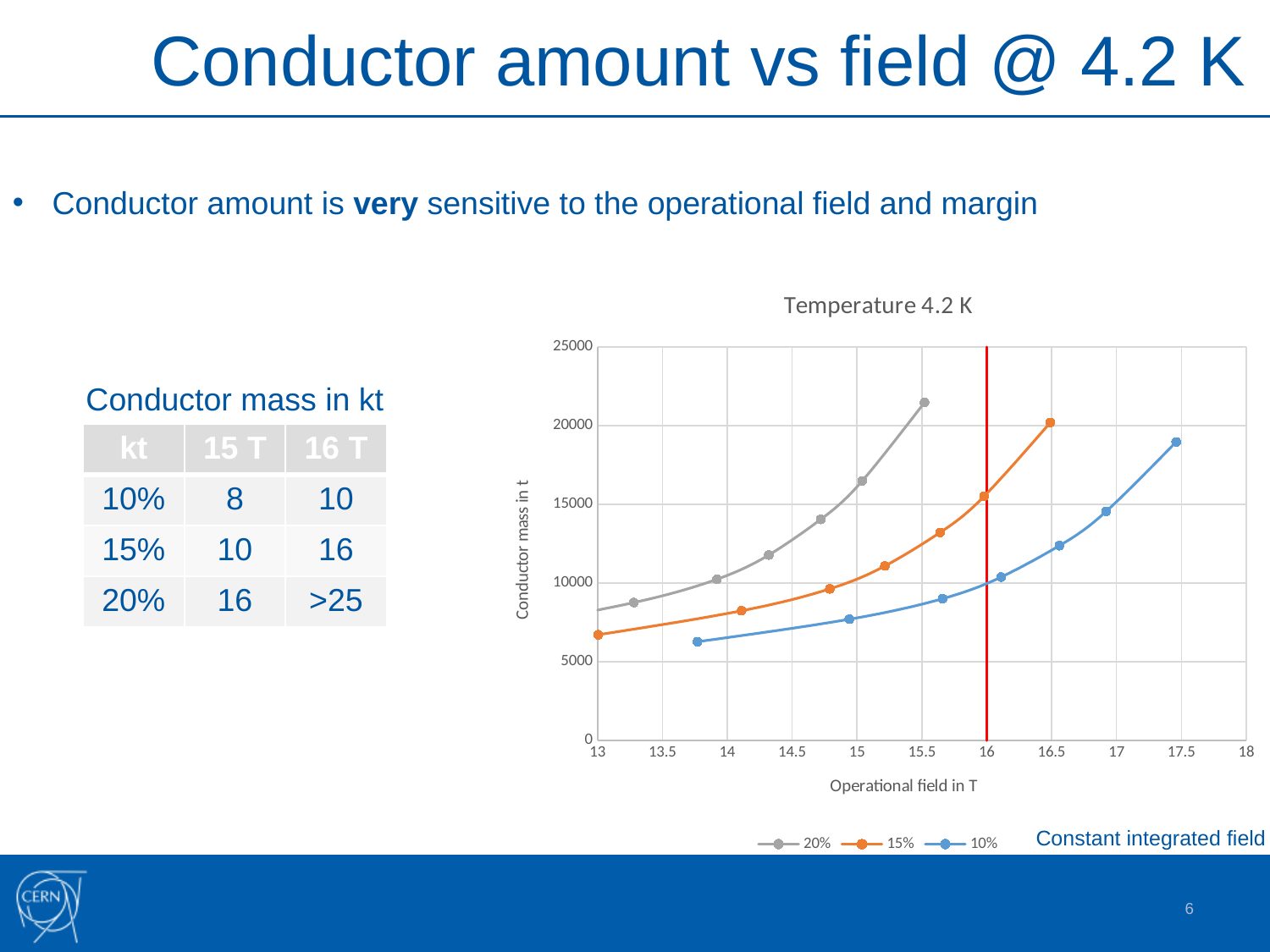
What kind of chart is shown under the title "Temperature 4.2 K"? line chart In the "Temperature 4.2 K" chart, is the highest point of the 10% series greater or less than 20000? less In the "Temperature 4.2 K" chart, is the value of the 20% series at 13 T greater or less than 10000? less What are the three series named in the legend of the "Temperature 4.2 K" chart? 20%, 15%, 10% In the "Temperature 4.2 K" chart, is the first point of the 10% series greater or less than 5000? greater In the "Temperature 4.2 K" chart, which series has the lowest conductor mass at its starting point? 10% In the "Temperature 4.2 K" chart, which series reaches the highest conductor mass? 20% How many series does the legend of the "Temperature 4.2 K" chart list? 3 In the "Temperature 4.2 K" chart, at an operational field of 15 T, which series has the larger conductor mass, 20% or 15%? 20% What is the x-axis label of the "Temperature 4.2 K" chart? Operational field in T In the "Temperature 4.2 K" chart, do the values of the 20% series rise or fall as the operational field increases? rise